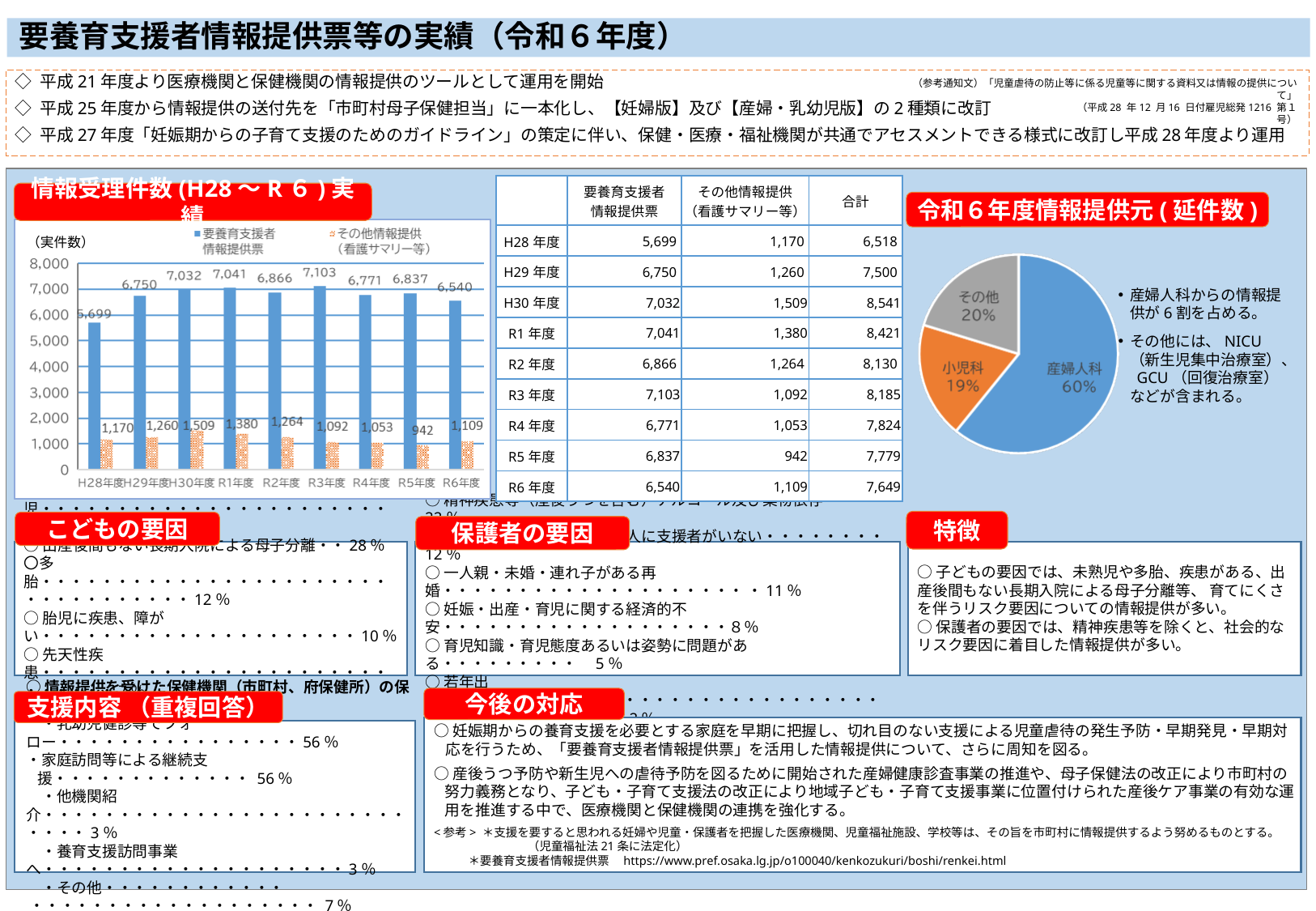
In the bar chart 情報受理件数(H28～R6)実績, what is the value of その他情報提供（看護サマリー等） for H30年度? 1,509 In the bar chart 情報受理件数(H28～R6)実績, which is larger: the 要養育支援者情報提供票 value for R4年度 or for R5年度? R5年度 In the pie chart 令和6年度情報提供元(延件数), what share does 産婦人科 have? 60% What kind of chart is 情報受理件数(H28～R6)実績? Bar chart In the bar chart 情報受理件数(H28～R6)実績, what is the value of 要養育支援者情報提供票 for R3年度? 7,103 In the bar chart 情報受理件数(H28～R6)実績, which fiscal year has the highest value for 要養育支援者情報提供票? R3年度 In the bar chart 情報受理件数(H28～R6)実績, how many fiscal years are shown on the x axis? 9 In the pie chart 令和6年度情報提供元(延件数), which category has the smallest share? 小児科 In the bar chart 情報受理件数(H28～R6)実績, which fiscal year has the lowest value for その他情報提供（看護サマリー等）? R5年度 In the bar chart 情報受理件数(H28～R6)実績, how many series does the legend list? 2 In the pie chart 令和6年度情報提供元(延件数), how many slices are there? 3 In the bar chart 情報受理件数(H28～R6)実績, what is the difference between the 要養育支援者情報提供票 values for H29年度 and H28年度? 1,051